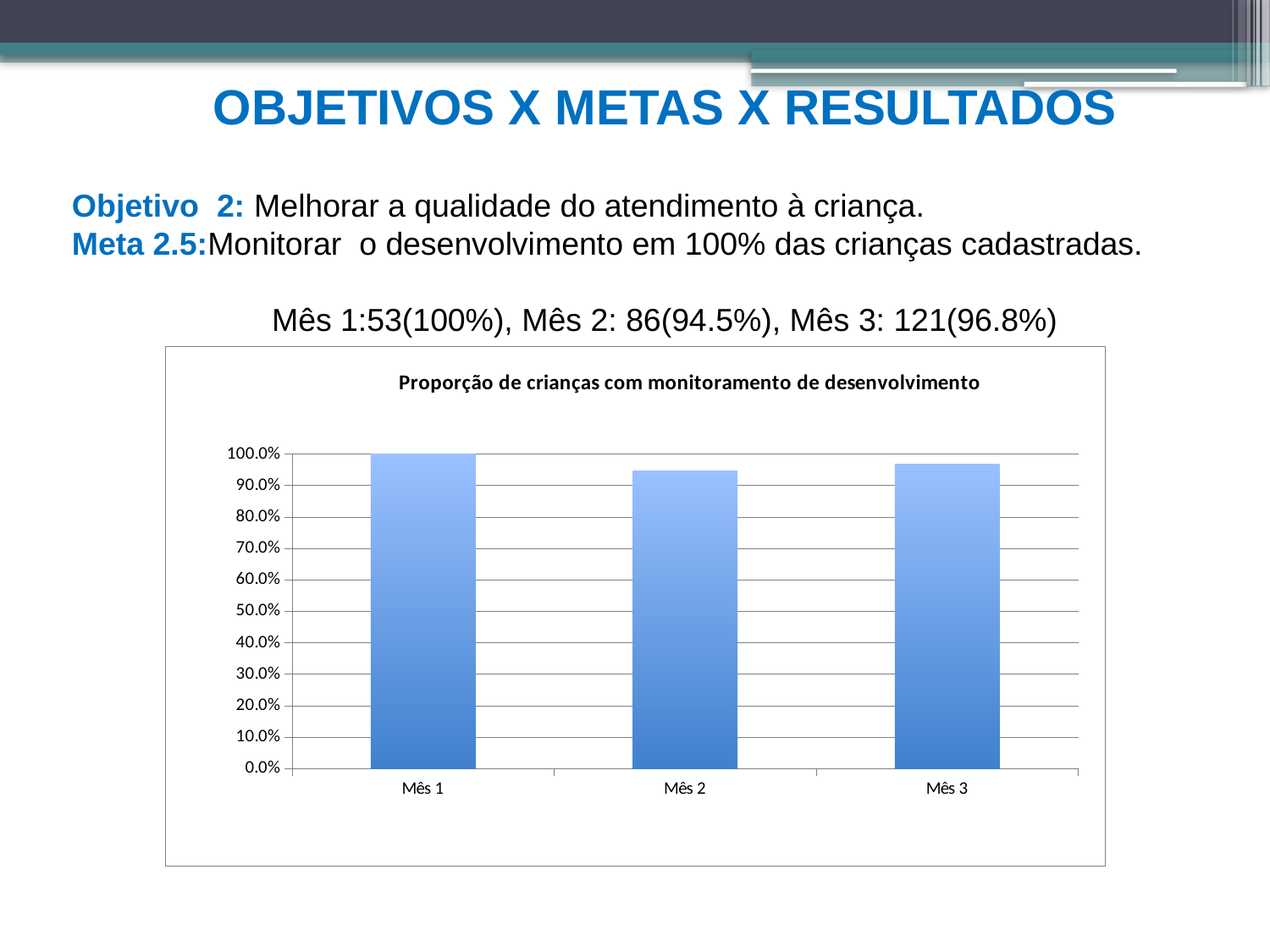
Which month has the lowest proportion in the chart? Mês 2 Which month has the highest proportion in the chart? Mês 1 Does the proportion rise or fall from Mês 1 to Mês 2? fall What is the value for Mês 3 in the chart? 96.8% What is the title of the chart? Proporção de crianças com monitoramento de desenvolvimento What type of chart is shown on the slide? bar chart Which is larger, the value for Mês 3 or the value for Mês 2? Mês 3 What is the value for Mês 2 in the chart? 94.5% What is the difference between the values for Mês 1 and Mês 2? 5.5% What is the value for Mês 1 in the chart? 100% How many categories (months) are plotted in the chart? 3 Is the value for Mês 2 greater or less than 90.0%? greater